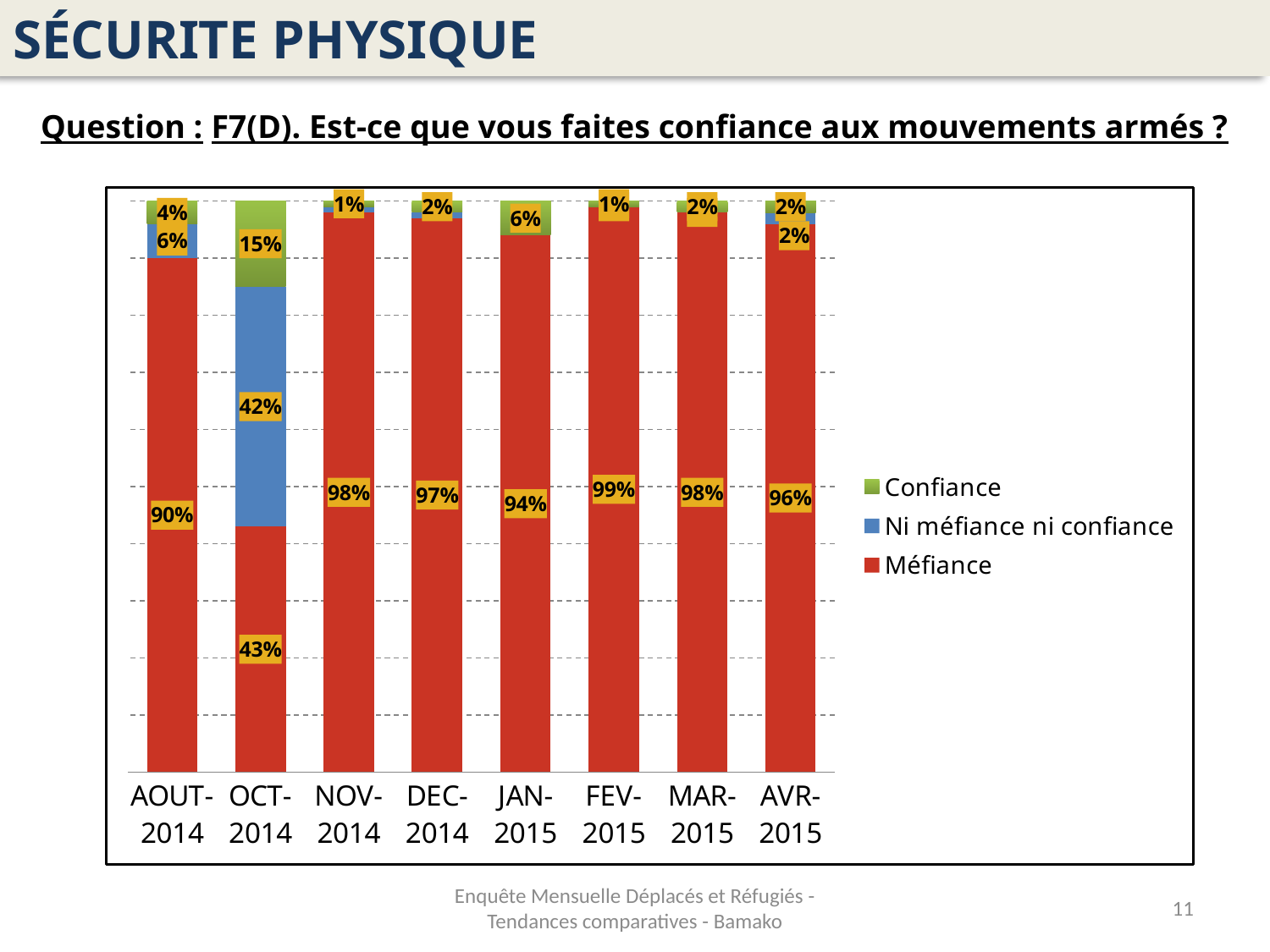
What is the Méfiance value for AOUT-2014? 90% How many months (categories) are shown on the x axis? 8 What is the Ni méfiance ni confiance value for OCT-2014? 42% Which is larger, the Méfiance value for JAN-2015 or for AVR-2015? AVR-2015 What is the Méfiance value for OCT-2014? 43% What is the Confiance value for OCT-2014? 15% How many series does the legend list? 3 Which month has the lowest Méfiance value? OCT-2014 What is the difference between the Méfiance values for NOV-2014 and AOUT-2014? 8% Which month has the highest Méfiance value? FEV-2015 What is the Confiance value for JAN-2015? 6% What type of chart is shown on the slide? stacked bar chart